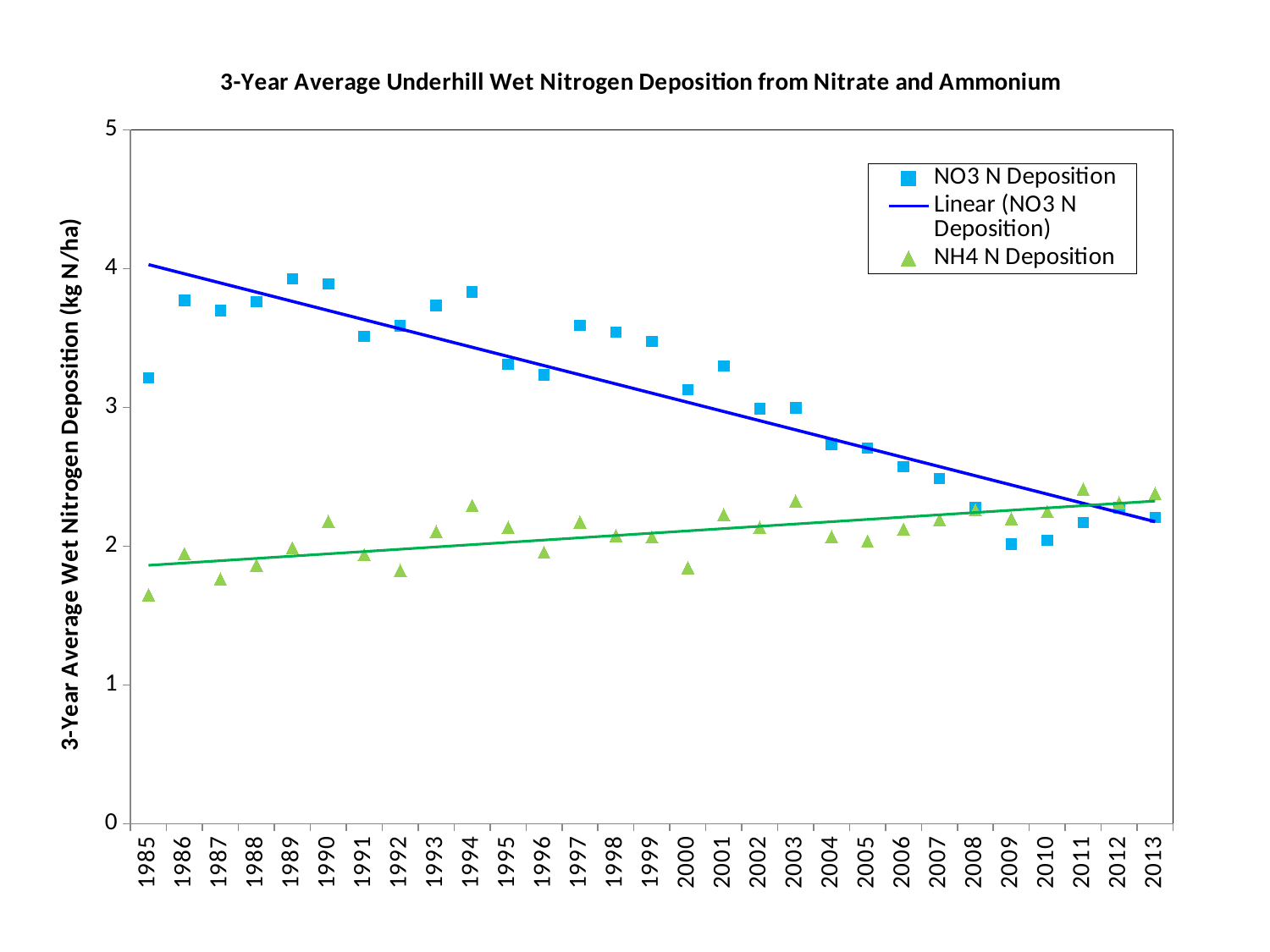
Is the NO3 N Deposition value for 1985 greater or less than 3? greater Is the NH4 N Deposition value for 2003 greater or less than 2? greater In 2011, which is larger: the NO3 N Deposition value or the NH4 N Deposition value? NH4 N Deposition Do the NO3 N Deposition values generally rise or fall from 1985 to 2013? fall Is the NO3 N Deposition value for 1989 greater or less than 4? less Do the NH4 N Deposition values generally rise or fall from 1985 to 2013? rise How many years are plotted along the x axis? 29 What is the label of the y axis? 3-Year Average Wet Nitrogen Deposition (kg N/ha) Which year has the lowest NH4 N Deposition value? 1985 How many entries does the legend list? 3 What kind of chart is shown on the slide? scatter chart